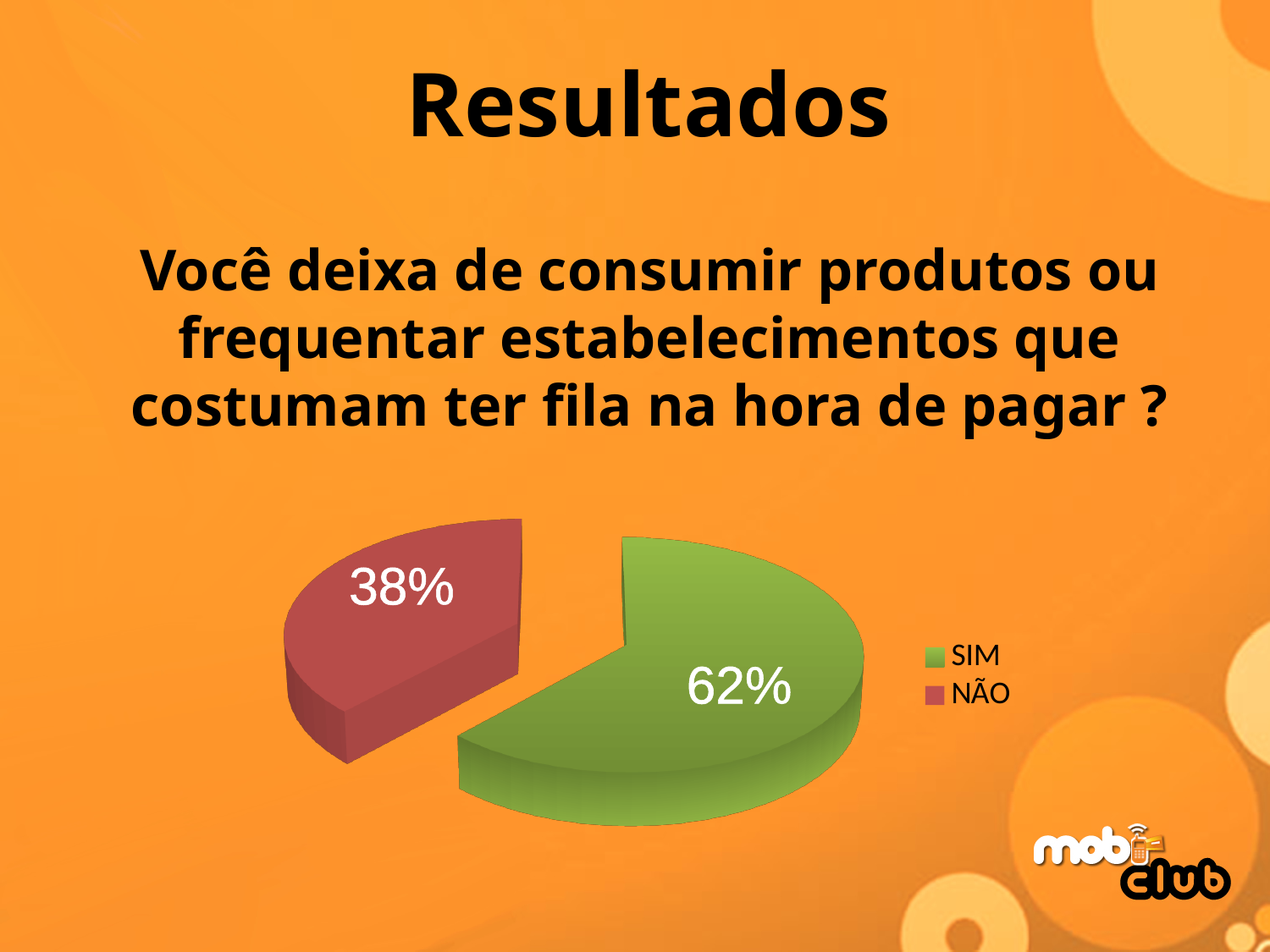
Which is larger, SIM or NÃO? SIM What kind of chart is shown on the slide? pie chart What colour is the NÃO slice? red How many entries does the legend list? 2 What share of the pie does SIM represent? 62% What colour is the SIM slice? green Which slice is the smallest? NÃO How many slices does the pie chart have? 2 Which slice is the largest? SIM What is the difference in percentage points between SIM and NÃO? 24 What share of the pie does NÃO represent? 38%